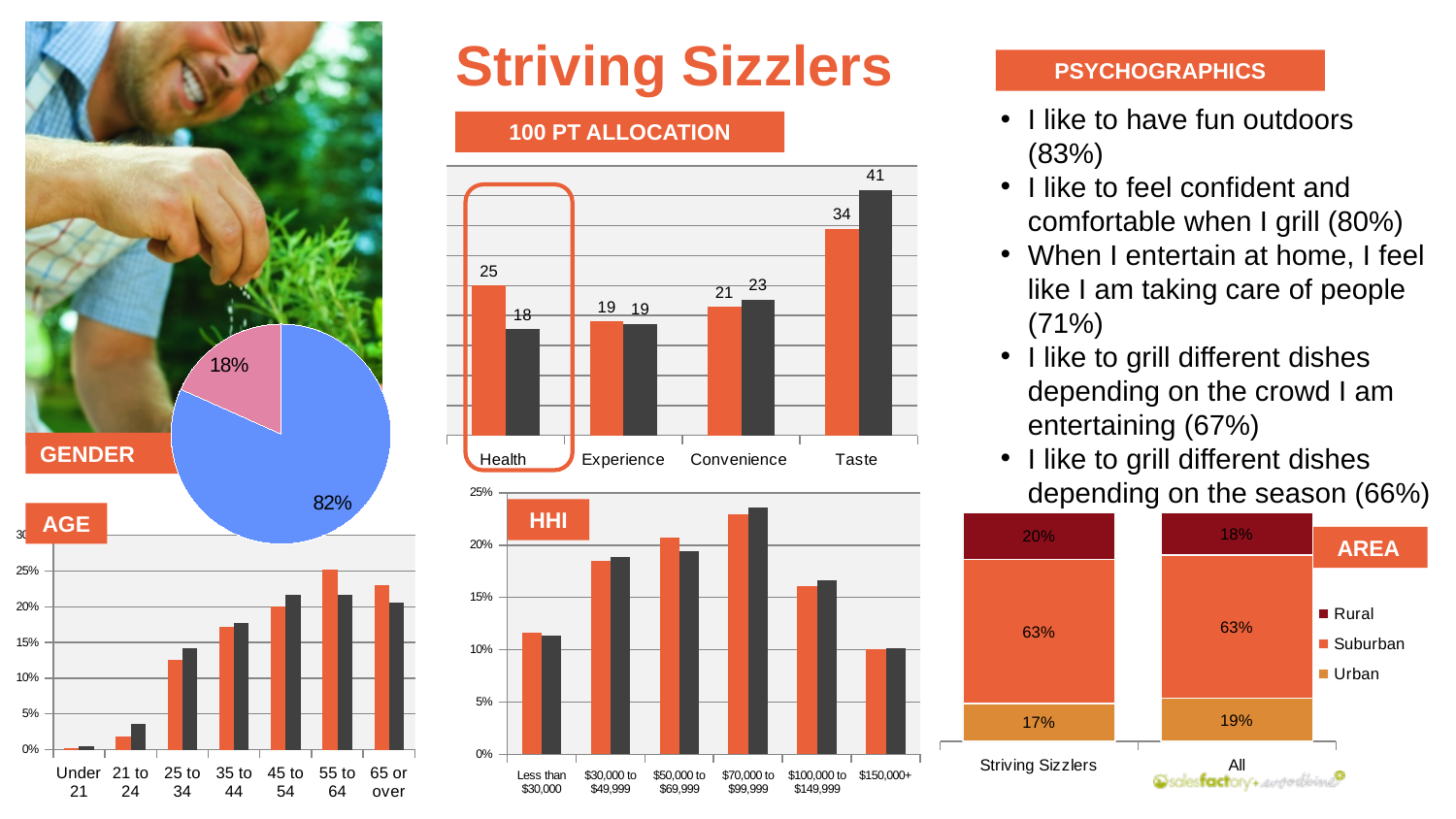
In the HHI chart, is the orange bar for Less than $30,000 greater or less than 15%? less In the GENDER pie chart, what percentage does the larger blue slice show? 82% In the AREA chart, how many series does the legend list? 3 In the AREA chart, what is the Urban share for All? 19% In the 100 PT ALLOCATION chart, what is the value of the orange bar for Health? 25 In the 100 PT ALLOCATION chart, what is the value of the dark bar for Taste? 41 In the GENDER pie chart, what percentage does the smaller pink slice show? 18% In the 100 PT ALLOCATION chart, how many categories are shown on the x axis? 4 In the 100 PT ALLOCATION chart, what is the difference between the two bars for Taste? 7 In the AREA chart, what is the Suburban share for Striving Sizzlers? 63% In the 100 PT ALLOCATION chart, which category has the highest values? Taste In the AGE chart, is the orange bar for 55 to 64 greater or less than 20%? greater